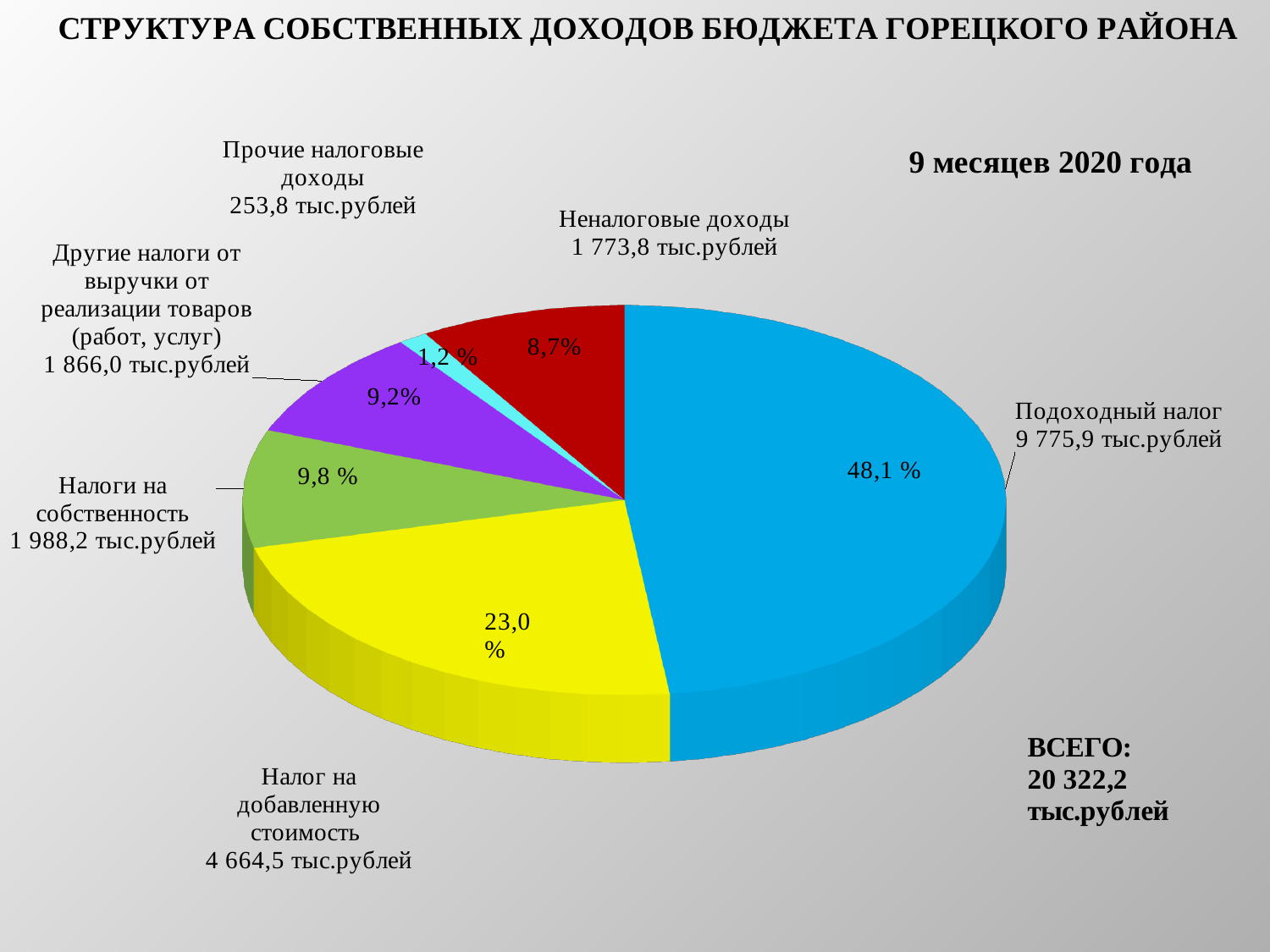
Which category has the smallest slice of the pie? Прочие налоговые доходы What share of the pie does Налог на добавленную стоимость account for? 23,0 % What is the value shown for Неналоговые доходы? 1 773,8 тыс.рублей How many slices does the pie chart have? 6 Which category has the largest slice of the pie? Подоходный налог What kind of chart is shown on the slide? Pie chart What total (ВСЕГО) is shown on the slide? 20 322,2 тыс.рублей What period does the chart cover, according to the slide? 9 месяцев 2020 года What is the difference in percentage points between the shares of Подоходный налог and Налог на добавленную стоимость? 25,1 What is the value shown for Налоги на собственность? 1 988,2 тыс.рублей What share of the pie does Подоходный налог account for? 48,1 % Which has a larger share: Налоги на собственность or Неналоговые доходы? Налоги на собственность